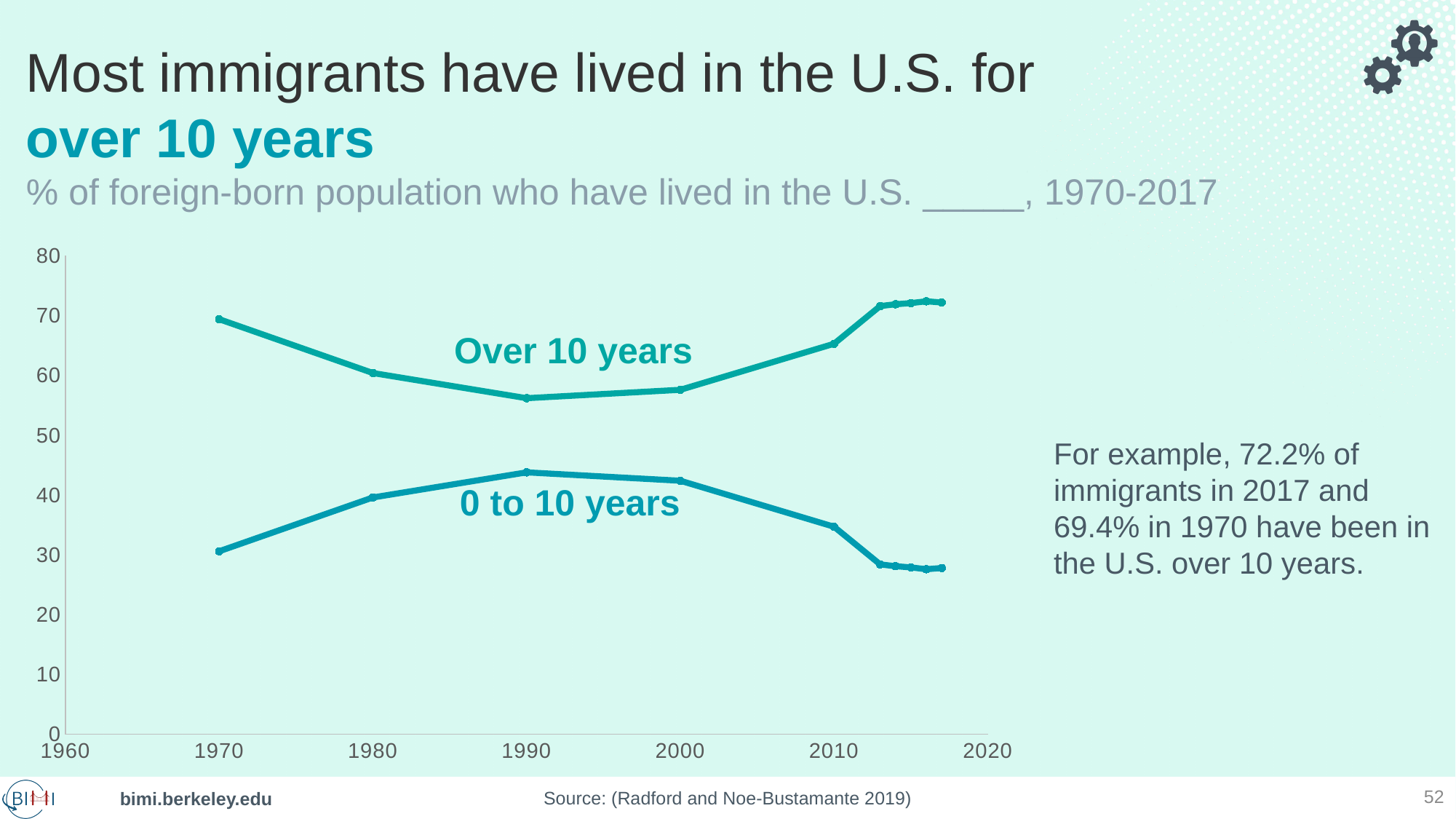
By how many percentage points did the 'Over 10 years' share in 2017 exceed the share in 1970? 2.8 Is the '0 to 10 years' value in 1990 greater or less than 40? greater Is the 'Over 10 years' value in 1990 greater or less than 60? less Does the 'Over 10 years' line rise or fall between 1970 and 1990? Fall In 1990, which series has the higher value, 'Over 10 years' or '0 to 10 years'? Over 10 years How many series are plotted on the chart? 2 According to the slide, what percentage of immigrants in 1970 had lived in the U.S. over 10 years? 69.4% According to the slide, what percentage of immigrants in 2017 had lived in the U.S. over 10 years? 72.2% What are the two series labels shown on the chart? Over 10 years; 0 to 10 years What type of chart is shown on the slide? Line chart Is the '0 to 10 years' value in 2017 greater or less than 30? less Does the '0 to 10 years' line rise or fall between 1990 and 2017? Fall